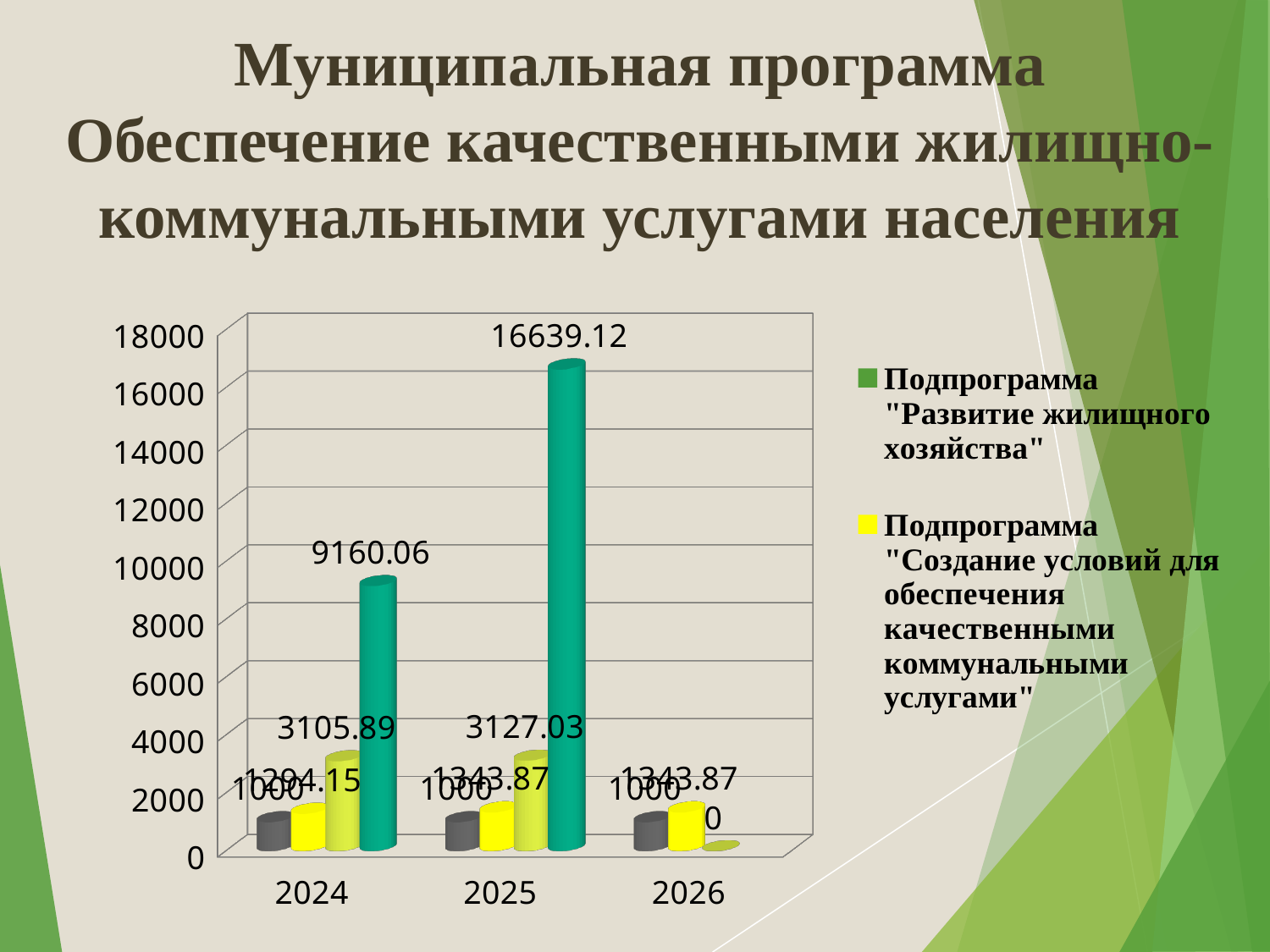
What is the value of the light green bar in 2025? 3127.03 By how much does the light green bar in 2025 (3127.03) exceed the light green bar in 2024 (3105.89)? 21.14 What is the value of the yellow bar in 2025? 1343.87 How many years are shown on the x axis? 3 Is the tallest bar in 2025 greater or less than 16000? greater What is the value of the tallest (teal) bar in 2024? 9160.06 Which year has the highest bar on the chart? 2025 What is the value of the tallest bar in 2025? 16639.12 What is the highest value shown on the vertical axis? 18000 What is the difference between the tallest bar in 2025 (16639.12) and the tallest bar in 2024 (9160.06)? 7479.06 What kind of chart is shown on the slide? bar chart What is the value of the light green bar in 2024? 3105.89